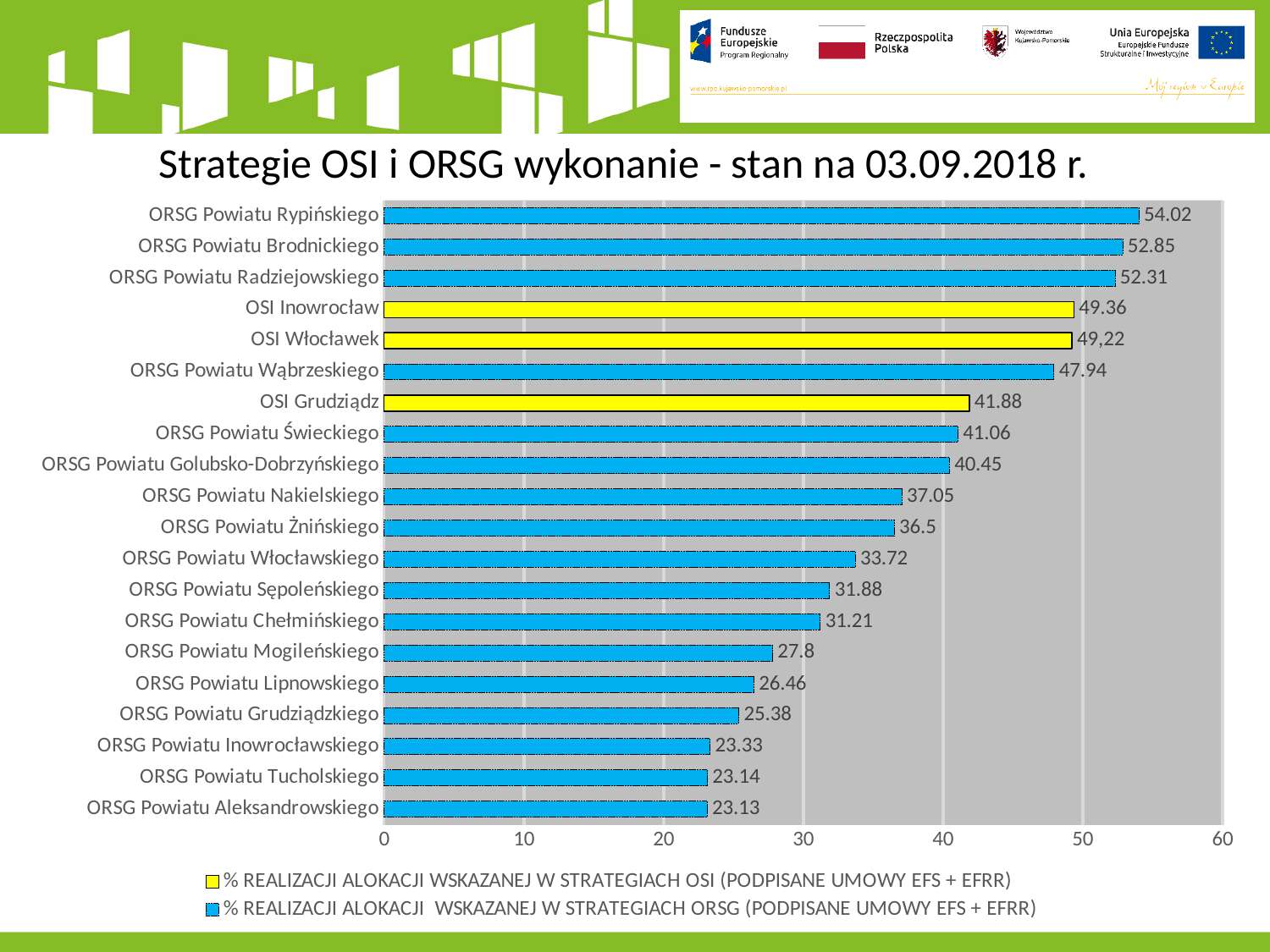
Which category has the highest value? ORSG Powiatu Rypińskiego Which is larger, the value for OSI Inowrocław or the value for ORSG Powiatu Wąbrzeskiego? OSI Inowrocław How many categories are shown on the chart? 20 Which category has the lowest value? ORSG Powiatu Aleksandrowskiego What kind of chart is shown on the slide? bar chart What is the value for ORSG Powiatu Żnińskiego? 36.5 How many series does the legend list? 2 What is the value for ORSG Powiatu Rypińskiego? 54.02 What is the value for ORSG Powiatu Mogileńskiego? 27.8 What is the value for OSI Grudziądz? 41.88 Is the value for ORSG Powiatu Nakielskiego greater or less than 40? less What is the difference between the values for ORSG Powiatu Brodnickiego and ORSG Powiatu Radziejowskiego? 0.54